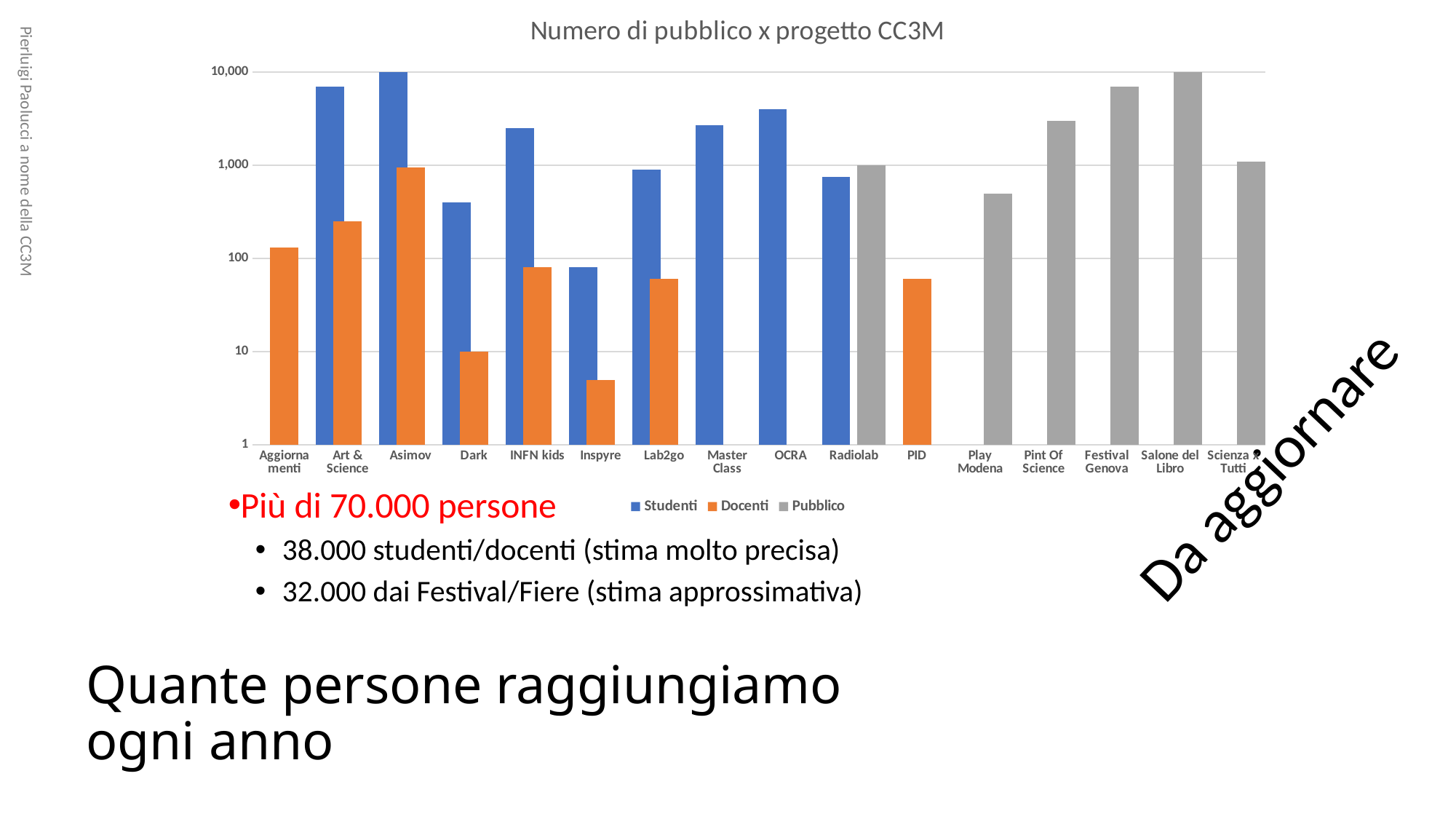
Which project has the highest Studenti value? Asimov What kind of chart is shown on the slide? bar chart Which project has the lowest Docenti value? Inspyre Which is larger, the Docenti value for Art & Science or the Docenti value for Dark? Art & Science How many project categories are shown on the x axis of the chart? 16 Is the Studenti value for OCRA greater or less than 1,000? greater How many series does the chart legend list? 3 Which project has the highest Pubblico value? Salone del Libro Is the Docenti value for Inspyre greater or less than 10? less What is the title of the chart? Numero di pubblico x progetto CC3M Is the Docenti value for Aggiornamenti greater or less than 100? greater Which project has the lowest Pubblico value? Play Modena